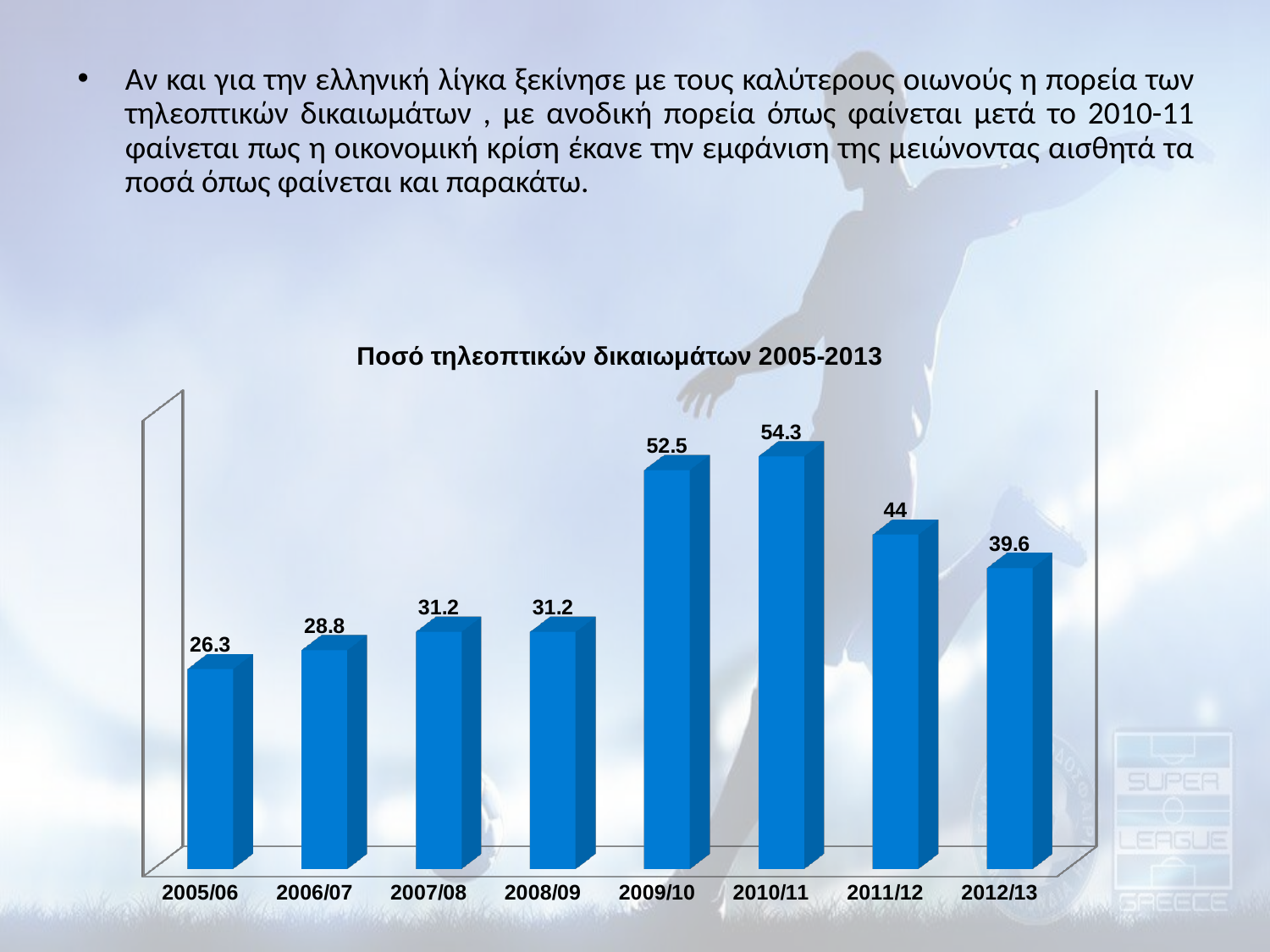
What is the title of the chart? Ποσό τηλεοπτικών δικαιωμάτων 2005-2013 What is the value for 2005/06? 26.3 Which season has the highest value? 2010/11 Which season has the lowest value? 2005/06 What is the value for 2012/13? 39.6 What kind of chart is shown on the slide? bar chart What is the difference between the values for 2010/11 and 2009/10? 1.8 Do the values rise or fall from 2010/11 to 2012/13? fall What is the value for 2010/11? 54.3 How many seasons are shown on the x axis? 8 Which is larger, the value for 2006/07 or the value for 2011/12? 2011/12 What is the difference between the values for 2011/12 and 2012/13? 4.4